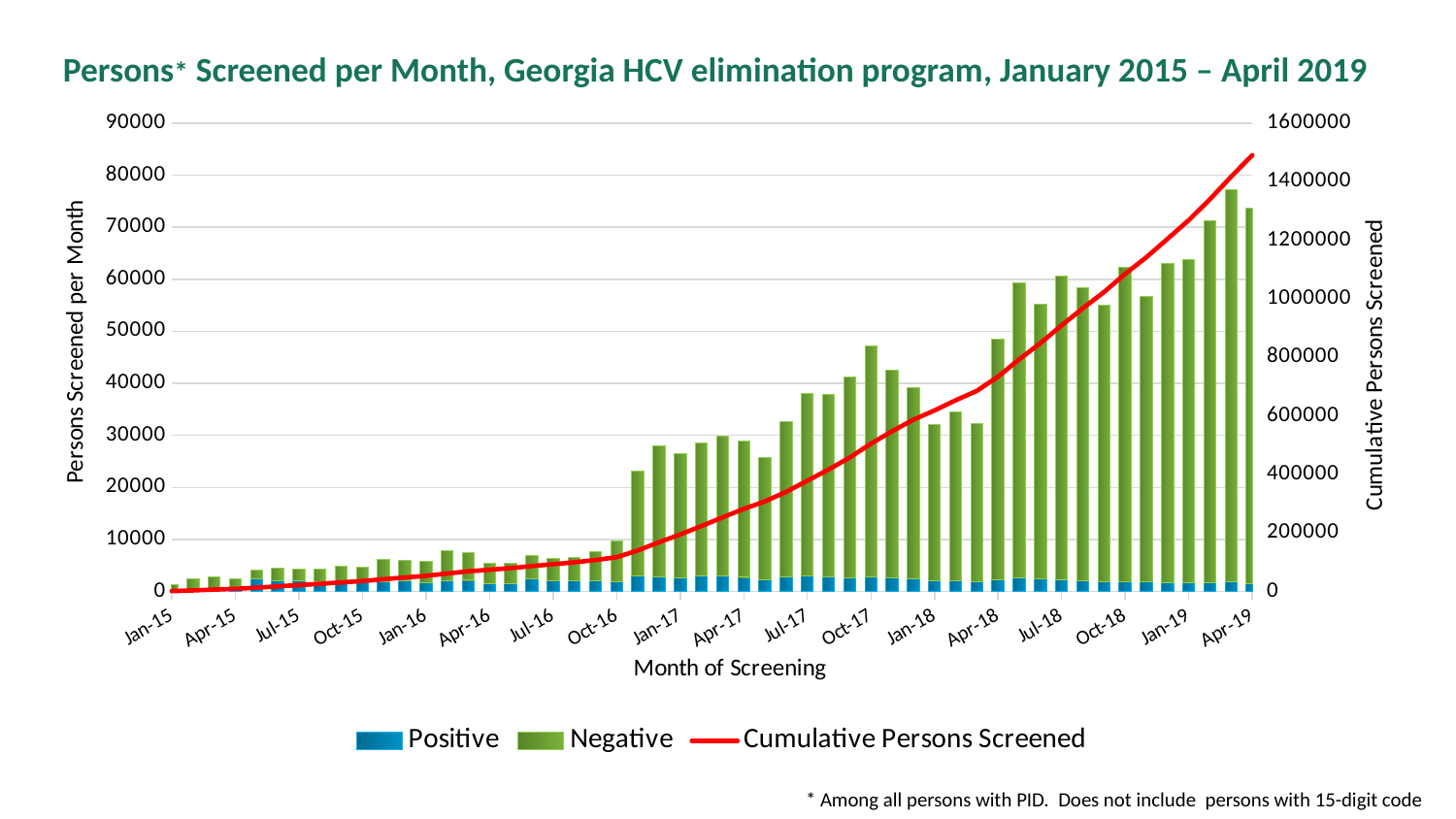
In Apr-19, which series is larger, Positive or Negative? Negative What is the title of the chart? Persons* Screened per Month, Georgia HCV elimination program, January 2015 – April 2019 Does the Cumulative Persons Screened line rise or fall from Jan-15 to Apr-19? Rises Is the total persons screened in Apr-19 greater or less than 70000? greater Is the Cumulative Persons Screened value at Apr-19 greater or less than 1400000? greater Is the total persons screened in Jan-16 greater or less than 10000? less What is the label of the right-hand vertical axis? Cumulative Persons Screened Which month has more persons screened, Apr-15 or Apr-19? Apr-19 How many series does the legend list? 3 What kind of chart is shown on the slide? A combined bar and line chart